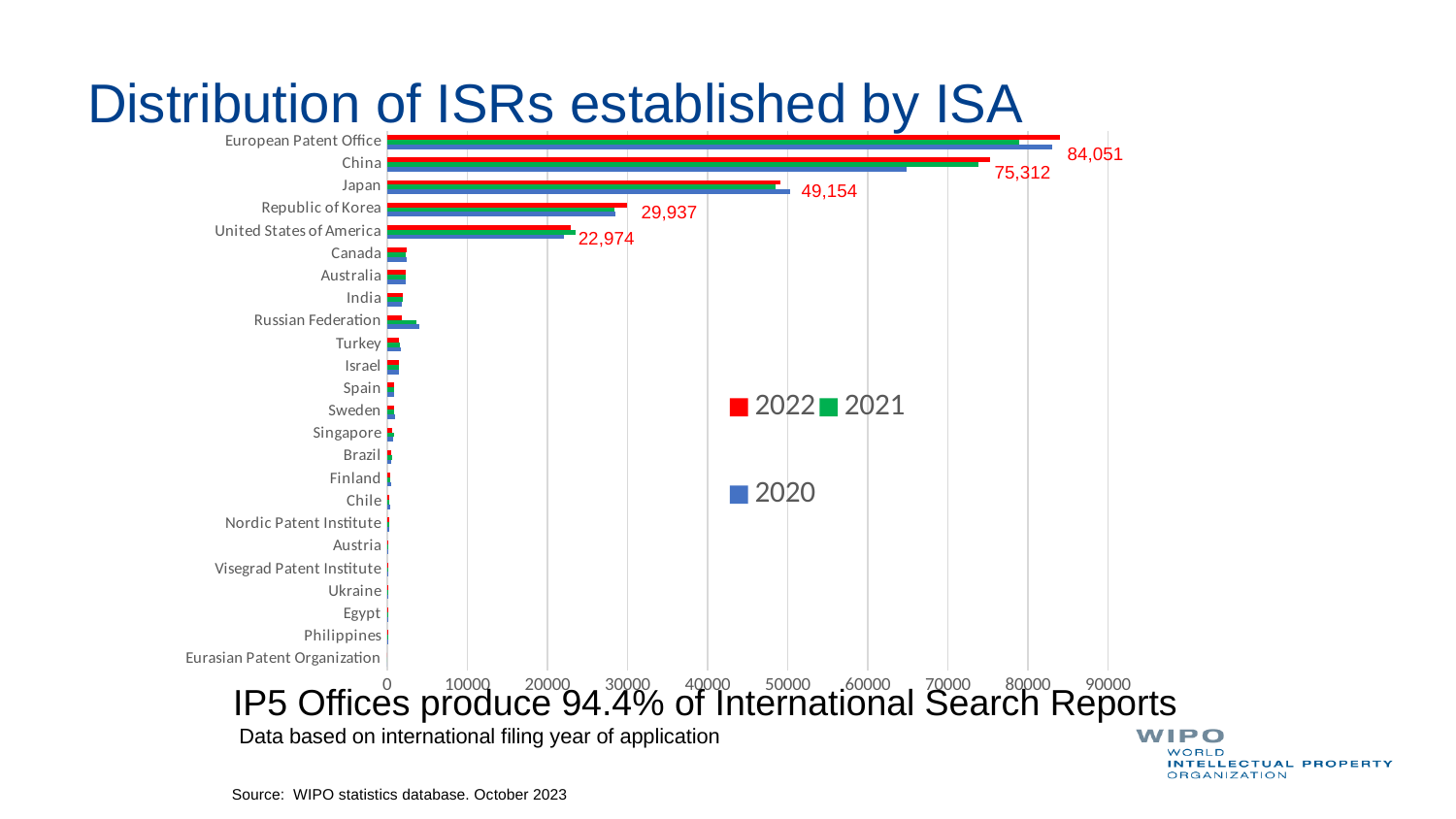
What is the 2022 value for China? 75,312 What is the 2022 value for the Republic of Korea? 29,937 Which ISA has the highest 2022 value? European Patent Office What is the 2022 value for Japan? 49,154 What is the difference between the 2022 values for Japan and the Republic of Korea? 19,217 What is the 2022 value for the European Patent Office? 84,051 How many series does the legend list? 3 How many ISAs are listed on the chart? 24 Which has the larger 2022 value, China or Japan? China Is the 2020 value for China greater or less than 60000? greater What is the difference between the 2022 values for the European Patent Office and China? 8,739 What is the 2022 value for the United States of America? 22,974